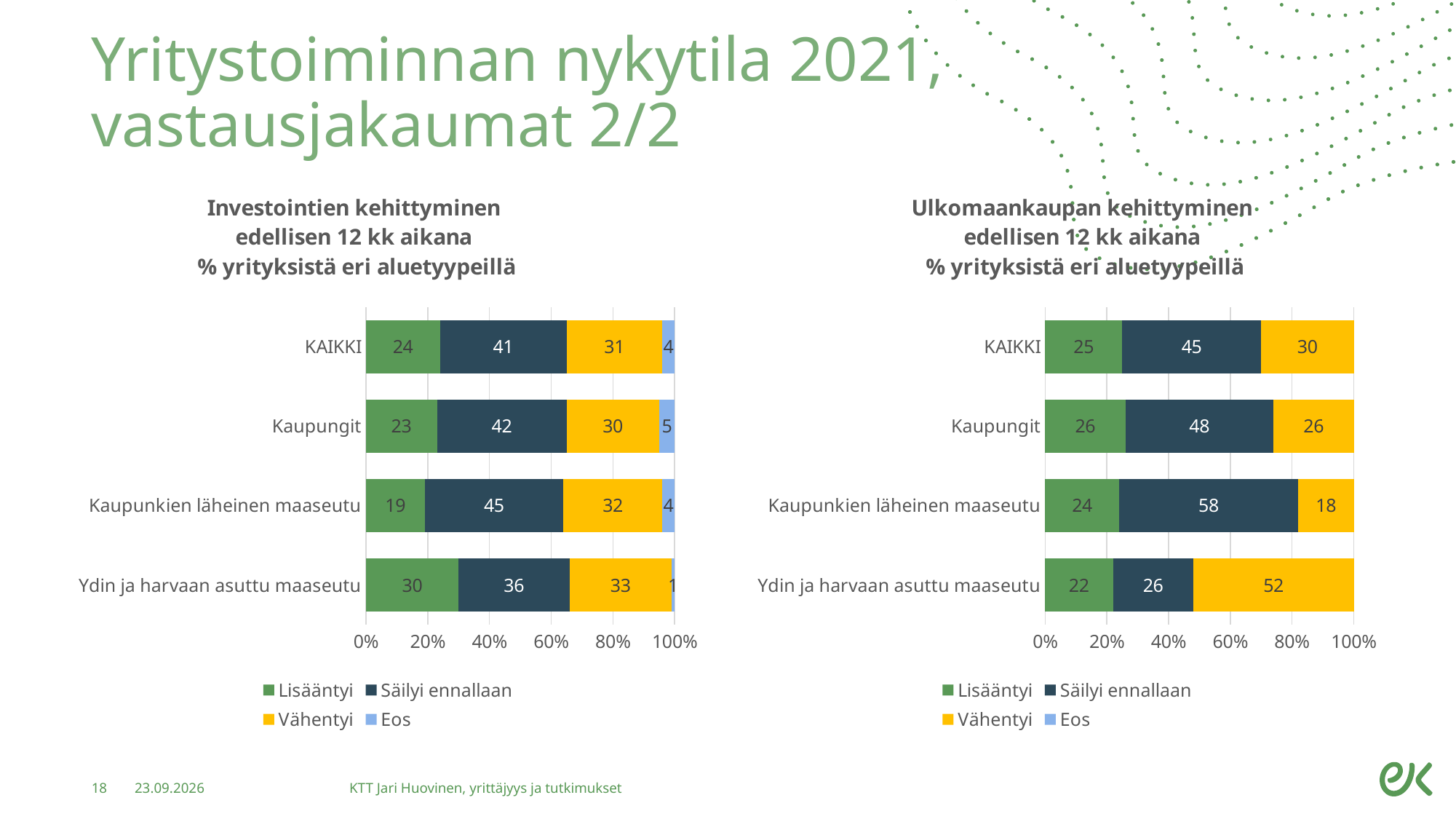
In the left chart (Investointien kehittyminen), what is the Säilyi ennallaan value for Kaupunkien läheinen maaseutu? 45 In the left chart (Investointien kehittyminen), what is the Eos value for Kaupungit? 5 In the right chart (Ulkomaankaupan kehittyminen), is the Lisääntyi value for Kaupungit larger or smaller than the Lisääntyi value for Ydin ja harvaan asuttu maaseutu? larger In the right chart (Ulkomaankaupan kehittyminen), which category has the lowest Vähentyi value? Kaupunkien läheinen maaseutu In the left chart (Investointien kehittyminen), which category has the highest Lisääntyi value? Ydin ja harvaan asuttu maaseutu How many categories are shown on the y axis of the left chart (Investointien kehittyminen)? 4 In the left chart (Investointien kehittyminen), what is the difference between the Vähentyi values for Ydin ja harvaan asuttu maaseutu and Kaupungit? 3 What type of chart is the left chart (Investointien kehittyminen)? Stacked bar chart In the right chart (Ulkomaankaupan kehittyminen), what is the Vähentyi value for Ydin ja harvaan asuttu maaseutu? 52 In the right chart (Ulkomaankaupan kehittyminen), what is the Säilyi ennallaan value for Kaupunkien läheinen maaseutu? 58 In the left chart (Investointien kehittyminen), what is the Lisääntyi value for KAIKKI? 24 How many series does the legend of the right chart (Ulkomaankaupan kehittyminen) list? 4